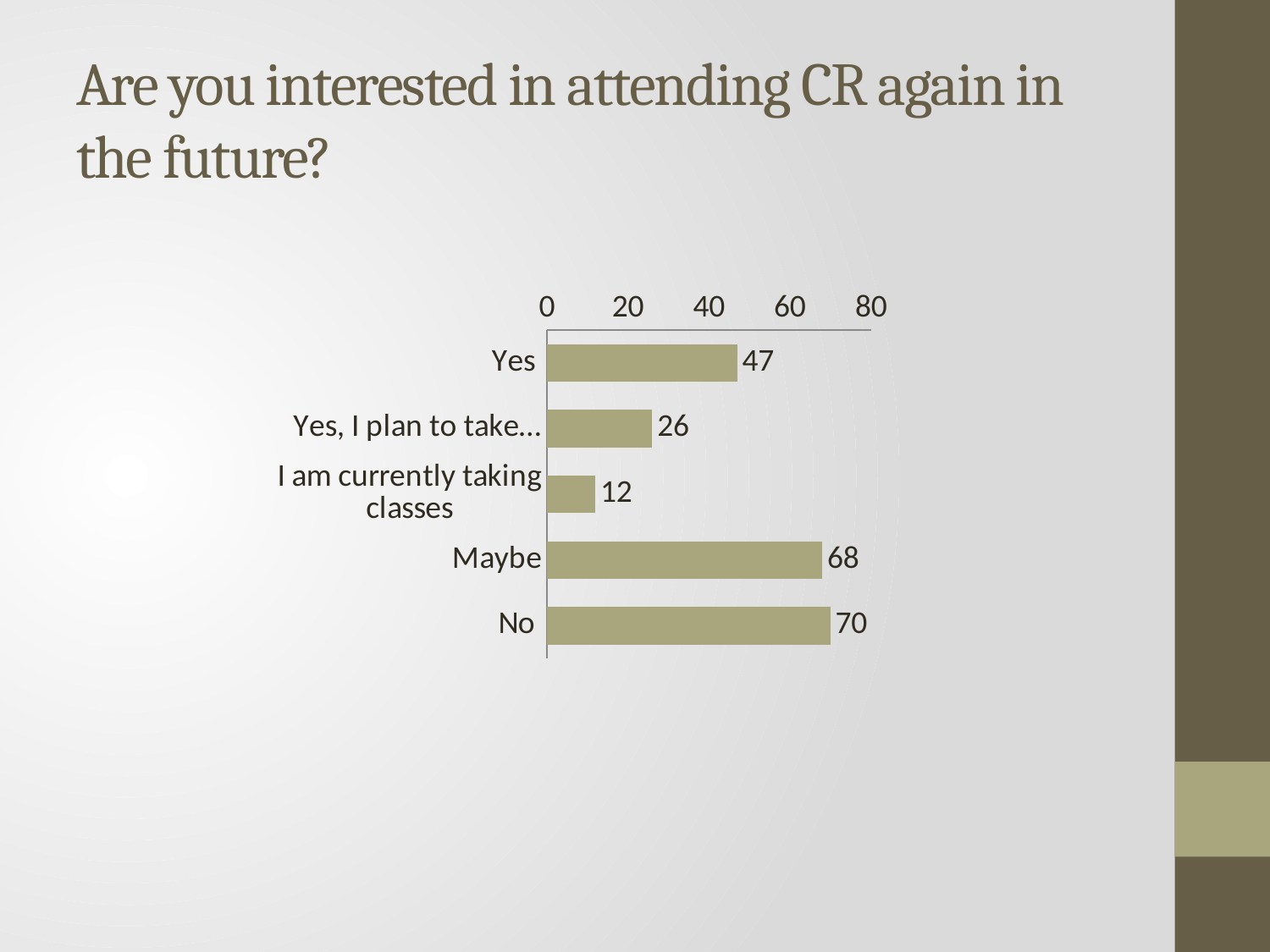
Which is larger, the value for "Yes" or the value for "Maybe"? Maybe What kind of chart is shown on the slide? bar chart Which category has the highest value? No Which category has the lowest value? I am currently taking classes What is the difference between the values for "Maybe" and "I am currently taking classes"? 56 What is the difference between the values for "No" and "Yes"? 23 What is the value for "No"? 70 What is the value for "Maybe"? 68 What is the value for "I am currently taking classes"? 12 How many categories are shown in the chart? 5 Is the value for "Yes" greater or less than 40? greater What is the value for "Yes"? 47